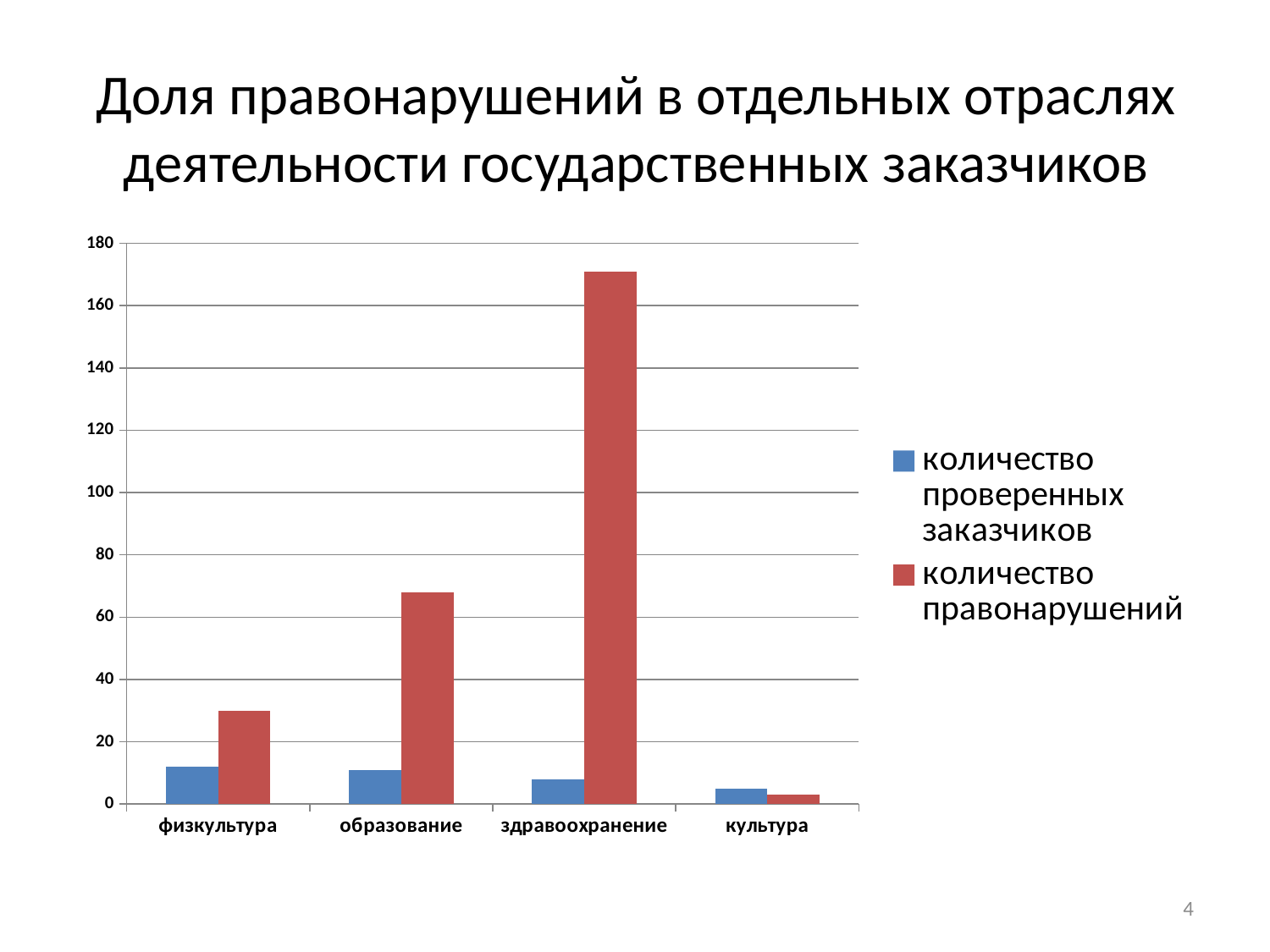
How many series does the legend list? 2 Which category has the highest value for количество правонарушений? здравоохранение Is the value of количество правонарушений for здравоохранение greater or less than 160? greater What kind of chart is shown on the slide? bar chart What colour represents количество правонарушений in the chart? red How many categories are shown on the x axis? 4 Which category has the lowest value for количество правонарушений? культура Which is larger for культура: количество проверенных заказчиков or количество правонарушений? количество проверенных заказчиков Which is larger for образование: количество проверенных заказчиков or количество правонарушений? количество правонарушений Is the value of количество правонарушений for образование greater or less than 60? greater Which category has the lowest value for количество проверенных заказчиков? культура Is the value of количество правонарушений for физкультура greater or less than 40? less